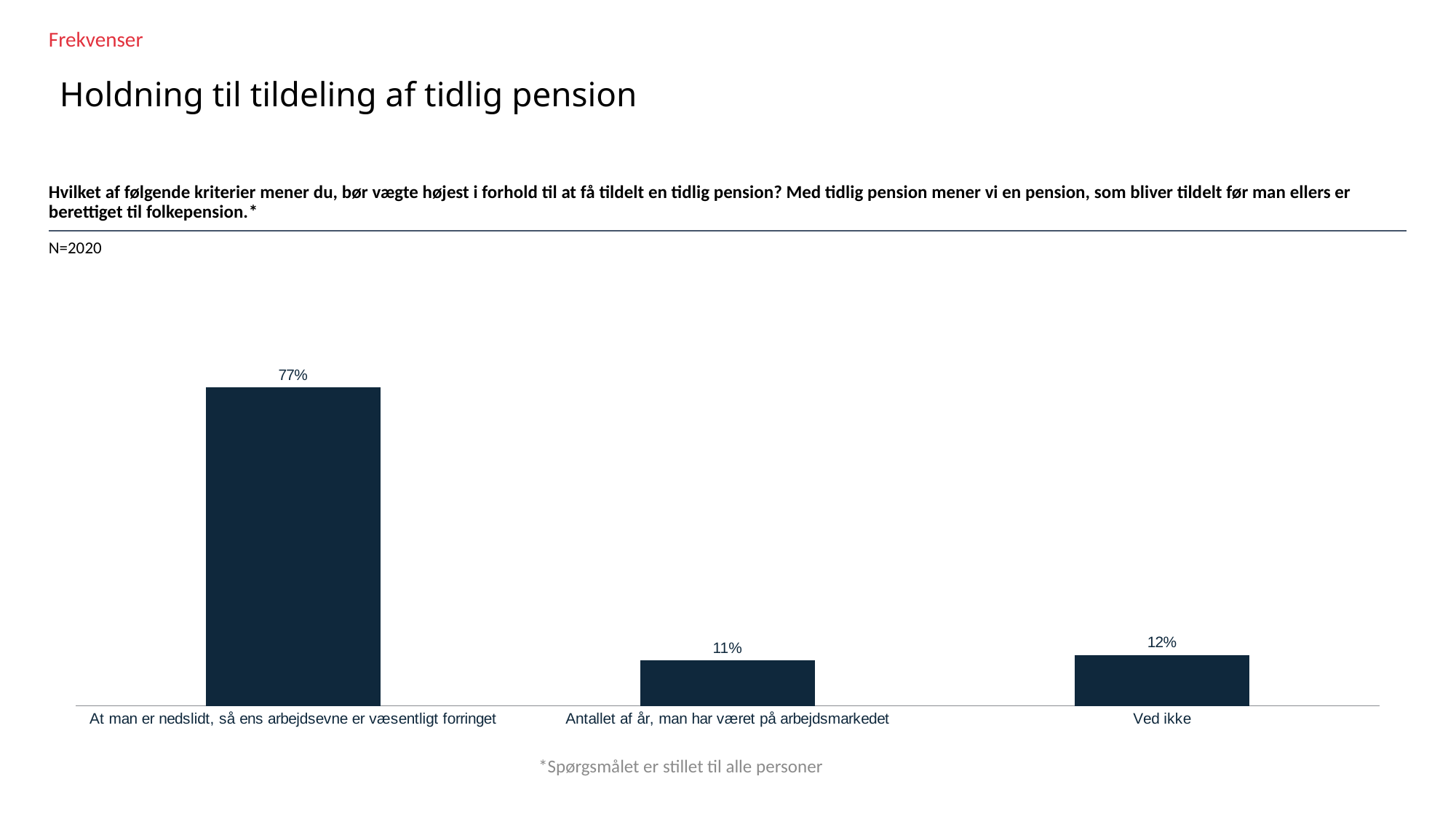
What is the difference between the values for "At man er nedslidt, så ens arbejdsevne er væsentligt forringet" and "Ved ikke"? 65% What is the value for "Antallet af år, man har været på arbejdsmarkedet"? 11% What is the title of the slide? Holdning til tildeling af tidlig pension What is the difference between the values for "Ved ikke" and "Antallet af år, man har været på arbejdsmarkedet"? 1% What is the sample size (N) stated for the chart? N=2020 Which is larger: the value for "At man er nedslidt, så ens arbejdsevne er væsentligt forringet" or the value for "Ved ikke"? At man er nedslidt, så ens arbejdsevne er væsentligt forringet How many categories are shown in the chart? 3 What is the value for "At man er nedslidt, så ens arbejdsevne er væsentligt forringet"? 77% What is the value for "Ved ikke"? 12% What kind of chart is shown on the slide? Bar chart Which category has the lowest value? Antallet af år, man har været på arbejdsmarkedet Which category has the highest value? At man er nedslidt, så ens arbejdsevne er væsentligt forringet